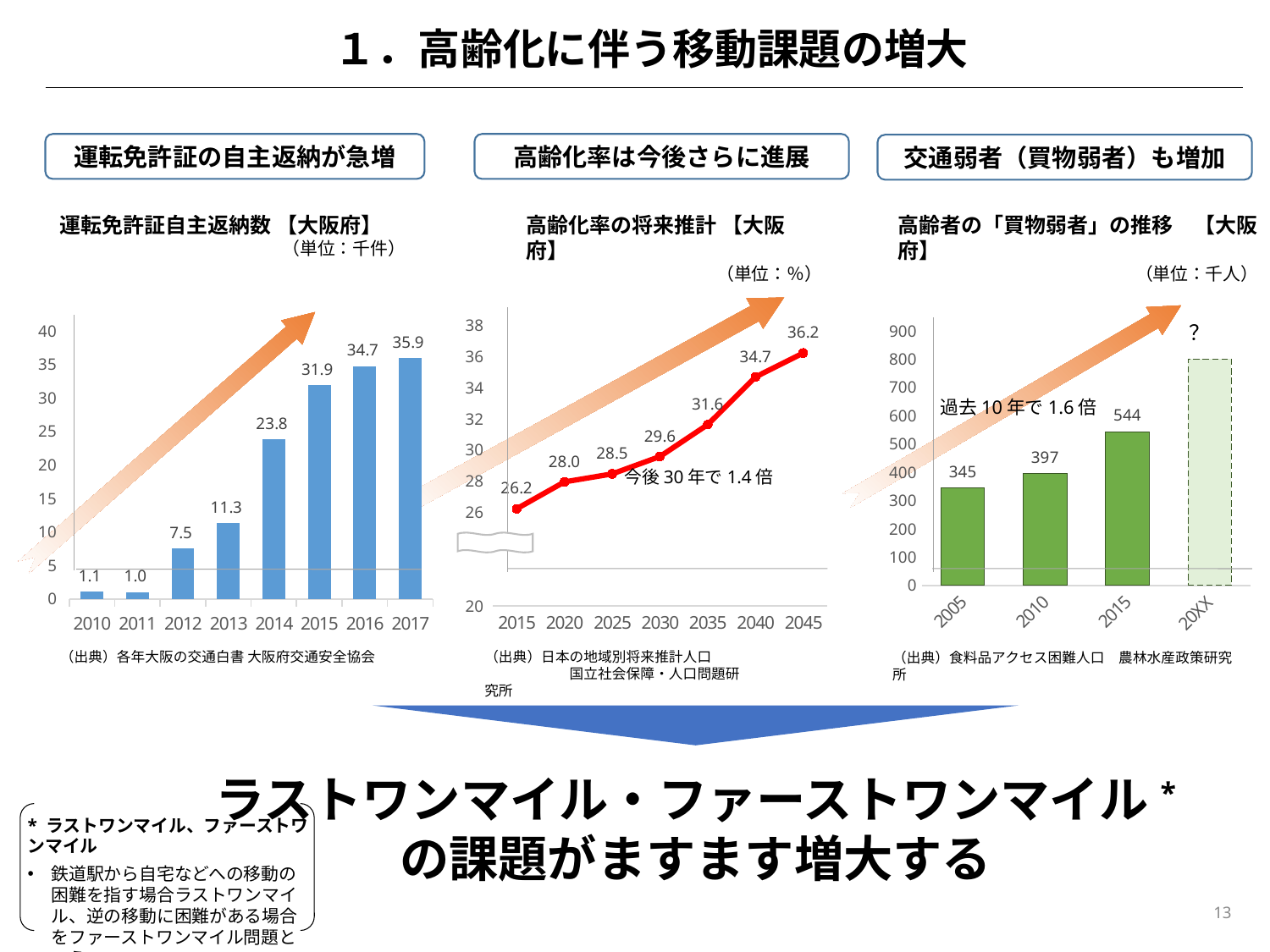
In the left chart (運転免許証自主返納数【大阪府】), what is the value for 2014? 23.8 In the middle chart (高齢化率の将来推計【大阪府】), what is the difference between the values for 2045 and 2015? 10.0 In the right chart (高齢者の「買物弱者」の推移【大阪府】), which is larger, the value for 2005 or the value for 2015? 2015 What kind of chart is the middle chart (高齢化率の将来推計【大阪府】)? line chart In the left chart (運転免許証自主返納数【大阪府】), what is the difference between the values for 2017 and 2010? 34.8 In the left chart (運転免許証自主返納数【大阪府】), which year has the highest value? 2017 In the right chart (高齢者の「買物弱者」の推移【大阪府】), what unit is shown for the values? 千人 In the left chart (運転免許証自主返納数【大阪府】), how many years are shown on the x axis? 8 In the middle chart (高齢化率の将来推計【大阪府】), what is the value for 2035? 31.6 In the left chart (運転免許証自主返納数【大阪府】), which year has the lowest value? 2011 In the middle chart (高齢化率の将来推計【大阪府】), do the values rise or fall from 2015 to 2045? rise In the right chart (高齢者の「買物弱者」の推移【大阪府】), what is the value for 2010? 397